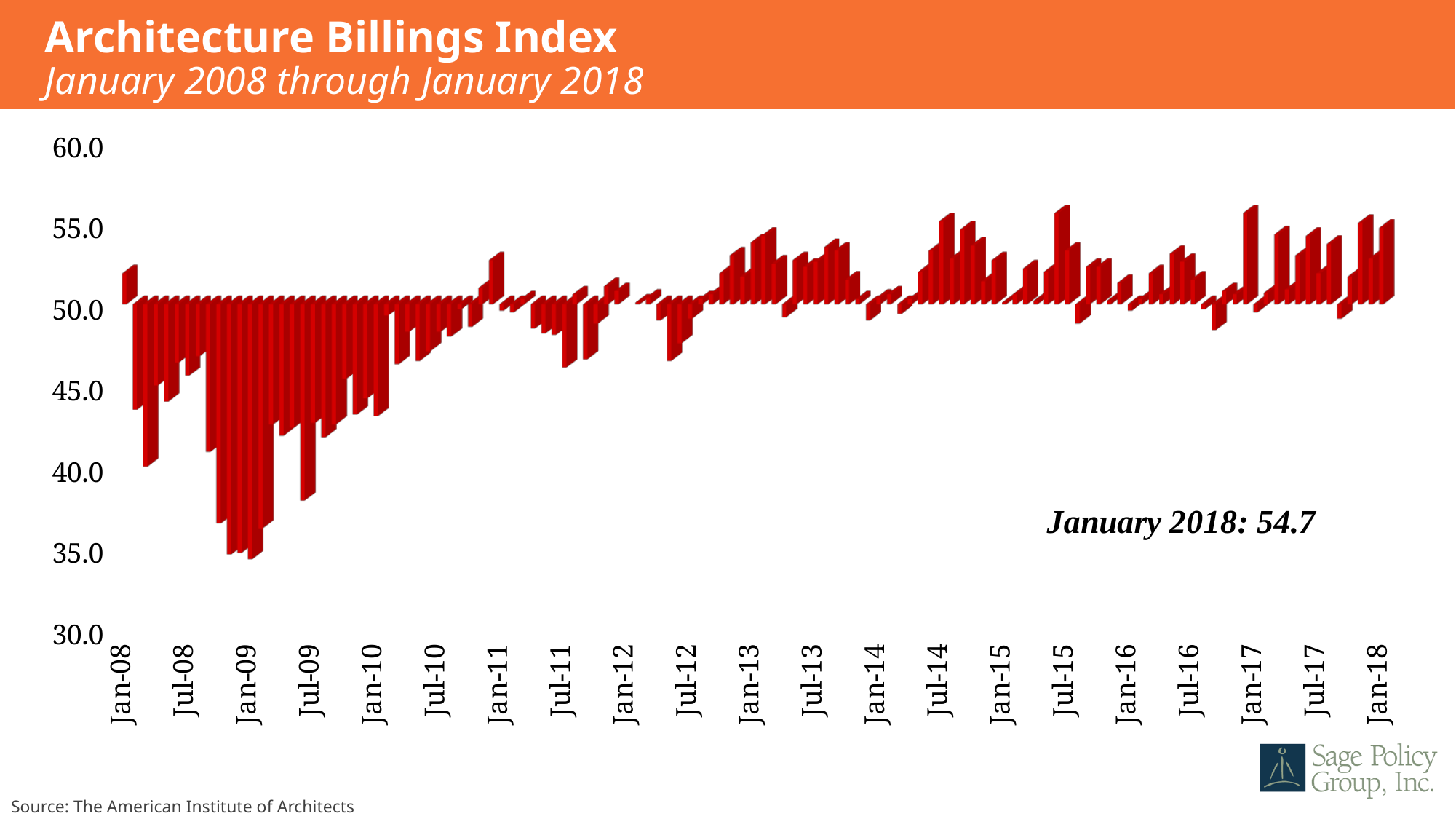
Is the value for Jan-18 greater or less than 50.0? greater Is the value for Jan-09 greater or less than 40.0? less Do the values generally rise or fall from Jan-09 to Jan-11? rise What kind of chart is shown on the slide? bar chart Is the value for Jan-10 greater or less than 50.0? less What period does the chart's subtitle say the data covers? January 2008 through January 2018 Do the values generally rise or fall from Jan-08 to Jan-09? fall What is the value of the Architecture Billings Index for January 2018? 54.7 What source is cited for the chart data? The American Institute of Architects